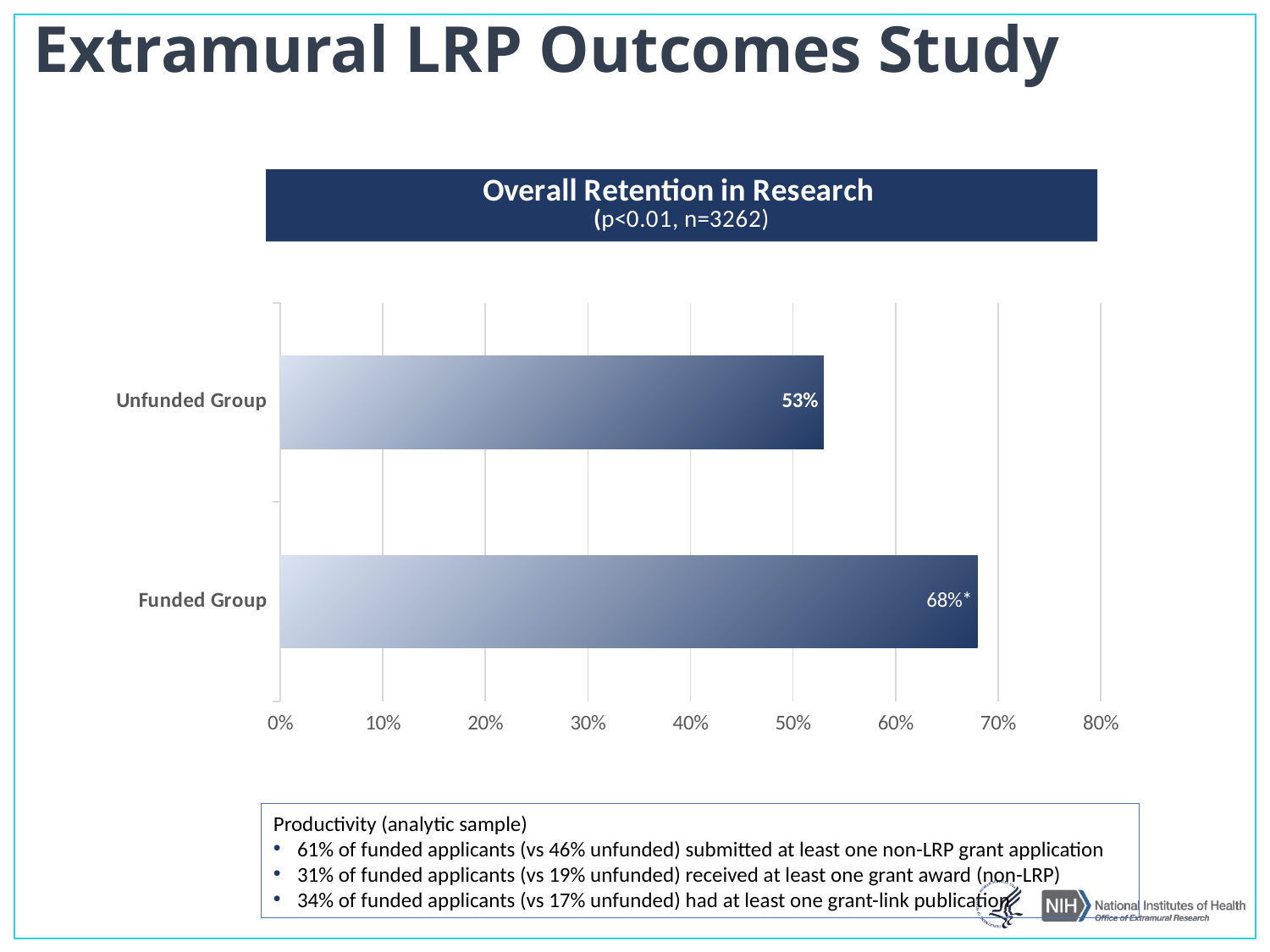
Is the value for the Funded Group larger or smaller than the value for the Unfunded Group? larger Which group has the higher retention value? Funded Group What kind of chart is shown on the slide? bar chart Is the value for the Unfunded Group greater or less than 60%? less What is the value for the Unfunded Group? 53% Is the value for the Funded Group greater or less than 60%? greater How many groups are plotted in the chart? 2 What is the title of the chart? Overall Retention in Research Which group has the lower retention value? Unfunded Group What is the sample size (n) shown in the chart title? 3262 What is the difference between the Funded Group and Unfunded Group values? 15% What is the value for the Funded Group? 68%*